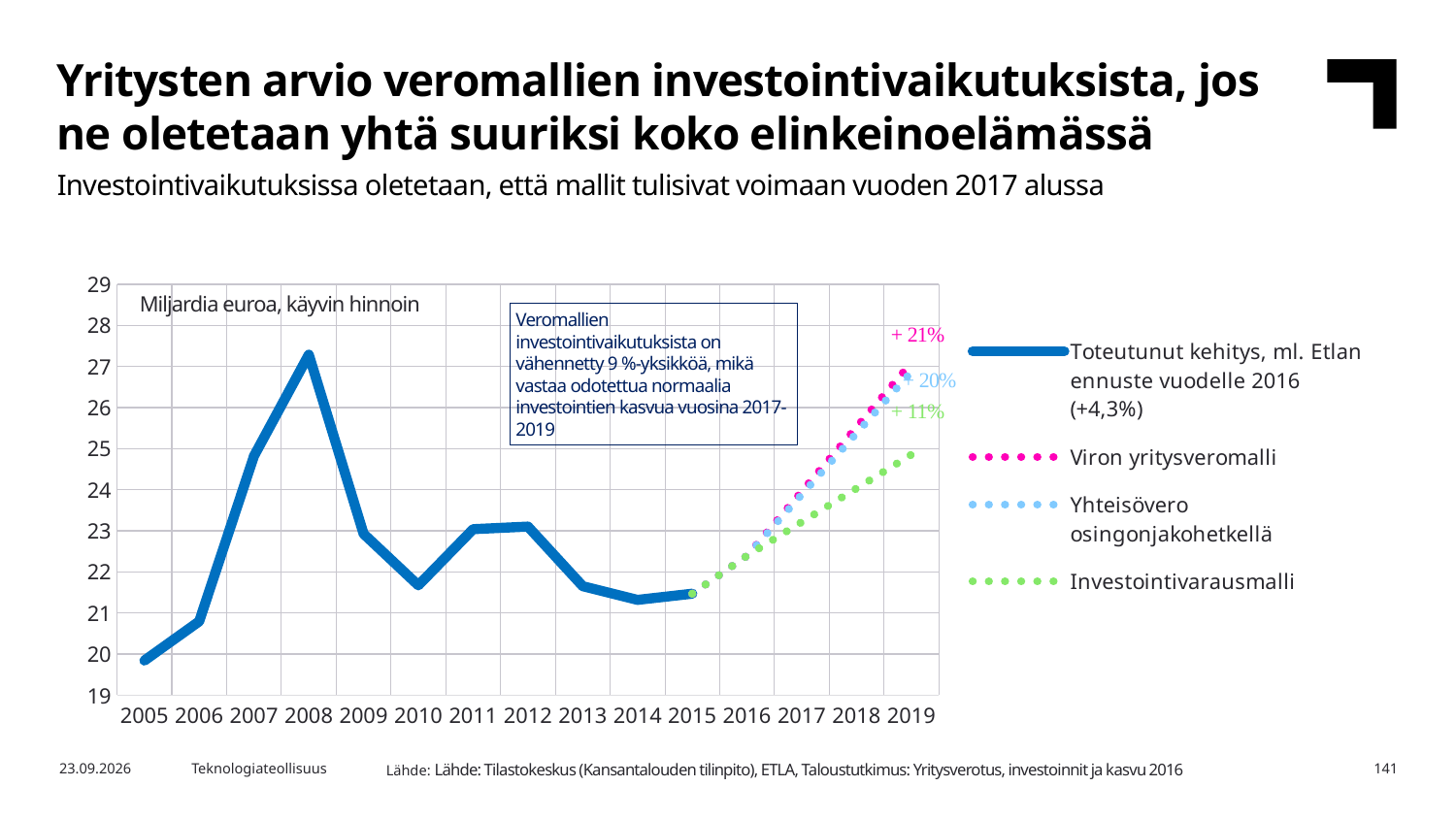
What percentage label is shown at the end of the Viron yritysveromalli series in 2019? + 21% In which year does the Toteutunut kehitys line reach its highest value? 2008 Is the value for 2014 on the Toteutunut kehitys line greater or less than 22? less Which year has the larger value on the Toteutunut kehitys line, 2007 or 2009? 2007 In which year does the Toteutunut kehitys line have its lowest value? 2005 What percentage label is shown at the end of the Investointivarausmalli series in 2019? + 11% What unit label is printed inside the chart area? Miljardia euroa, käyvin hinnoin What kind of chart is shown on the slide? line chart Do the values of the Toteutunut kehitys line rise or fall from 2008 to 2010? fall How many years are shown on the x axis? 15 How many series does the legend list? 4 Is the value for 2008 on the Toteutunut kehitys line greater or less than 26? greater